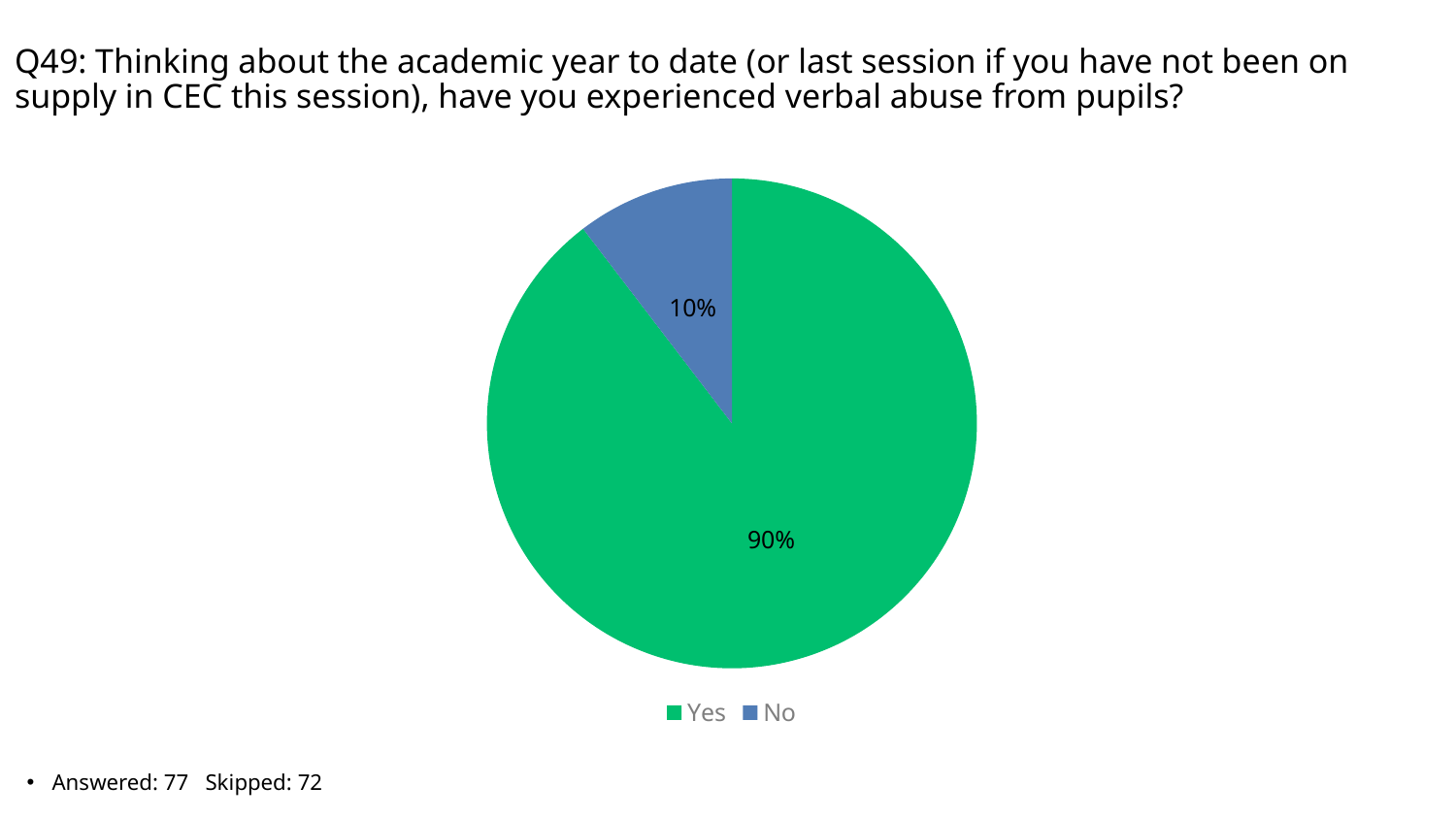
How many slices does the pie chart have? 2 What colour is the "No" slice? blue What is the difference in percentage points between the "Yes" and "No" slices? 80 Which response has the largest share of the pie? Yes How many entries does the legend list? 2 What kind of chart is shown on the slide? pie chart Which slice is larger, "Yes" or "No"? Yes What colour is the "Yes" slice? green What share of the pie does the "No" slice represent? 10% What percentage of respondents answered "No"? 10% Which response has the smallest share of the pie? No What percentage of respondents answered "Yes"? 90%